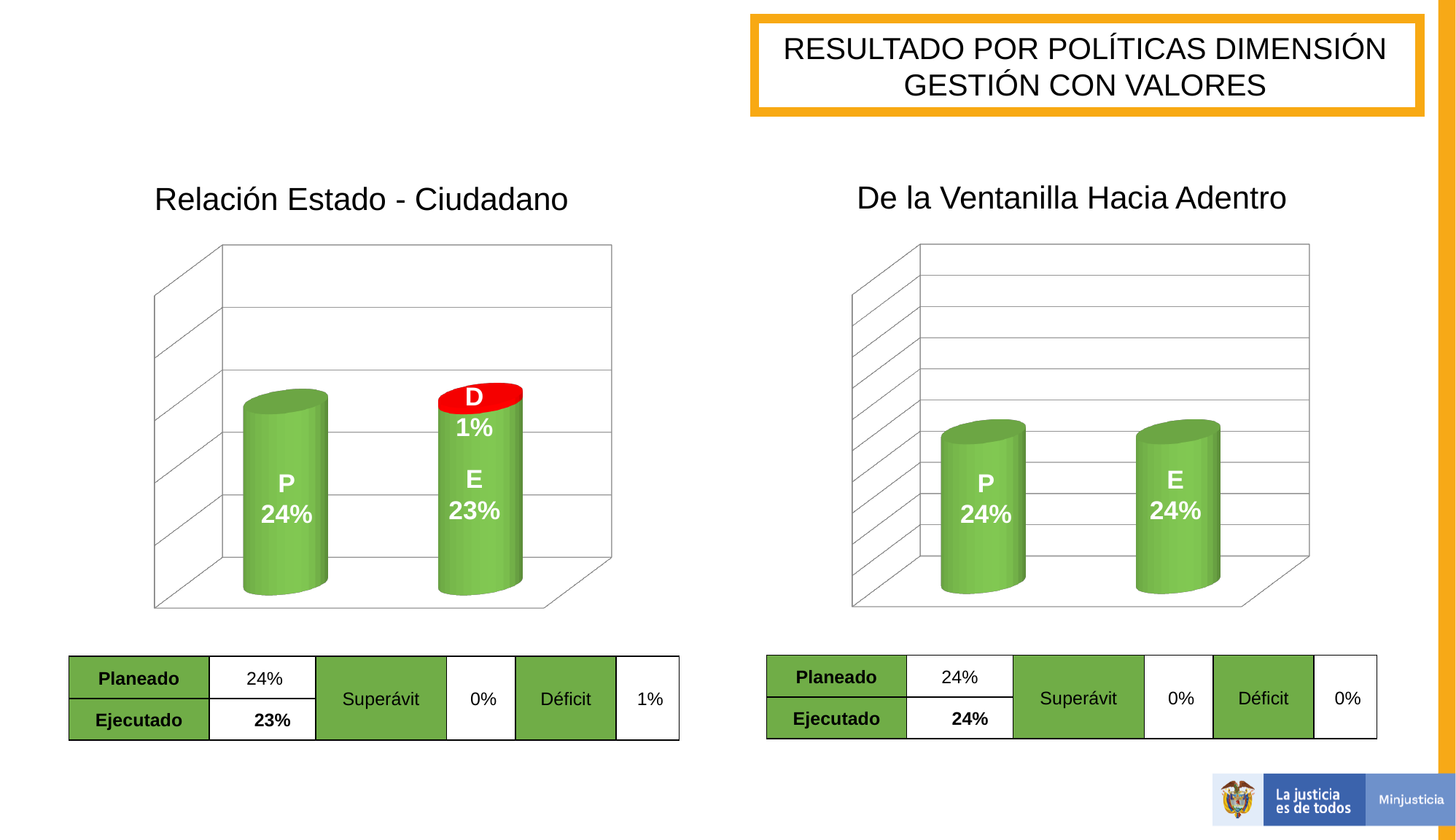
In the 'De la Ventanilla Hacia Adentro' chart, what is the difference between the P value and the E value? 0% In the 'Relación Estado - Ciudadano' chart, what is the value labelled on the E bar? 23% In the 'De la Ventanilla Hacia Adentro' chart, what is the value labelled on the P bar? 24% What is the title of the chart on the right side of the slide? De la Ventanilla Hacia Adentro In the 'Relación Estado - Ciudadano' chart, what is the difference between the P value and the E value? 1% In the 'Relación Estado - Ciudadano' chart, what colour is the D segment on top of the E bar? Red In the 'Relación Estado - Ciudadano' chart, what value is shown for the red D segment? 1% In the 'De la Ventanilla Hacia Adentro' chart, what is the value labelled on the E bar? 24% What kind of chart is the 'Relación Estado - Ciudadano' chart? Bar chart How many bars are plotted in the 'De la Ventanilla Hacia Adentro' chart? 2 In the 'Relación Estado - Ciudadano' chart, what is the total of the E bar including the D segment? 24% In the 'Relación Estado - Ciudadano' chart, what is the value labelled on the P bar? 24%